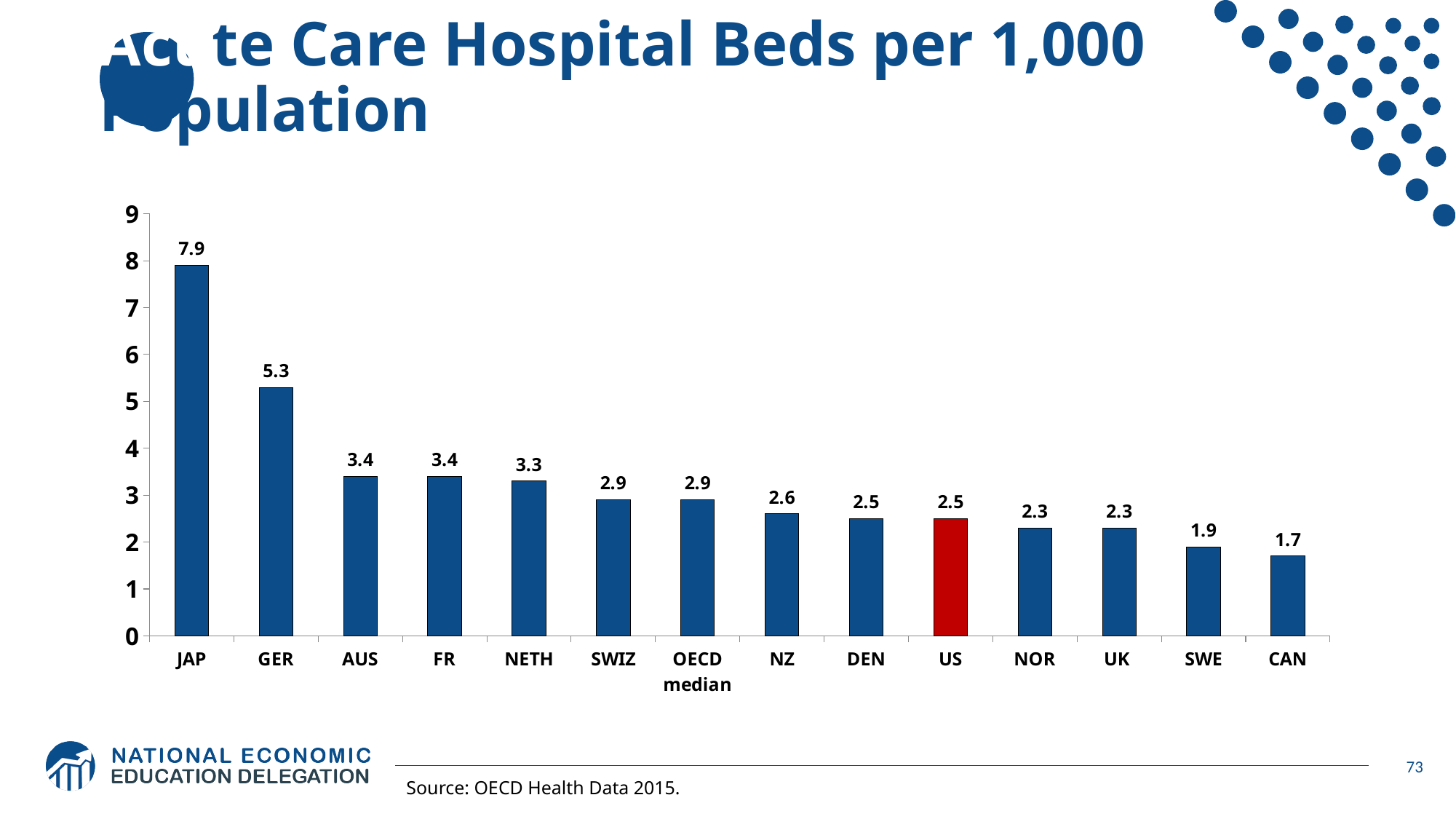
What is the value for JAP? 7.9 How many categories are shown on the x axis? 14 Which category has the lowest value? CAN Is the value for GER greater or less than 5? greater What is the value for the US? 2.5 What is the difference between the OECD median and the US value? 0.4 What kind of chart is shown on the slide? Bar chart What is the difference between the values for JAP and GER? 2.6 Which bar is coloured red rather than blue? US Which is larger, the value for NETH or the value for SWE? NETH Which category has the highest value? JAP What is the value for the OECD median? 2.9